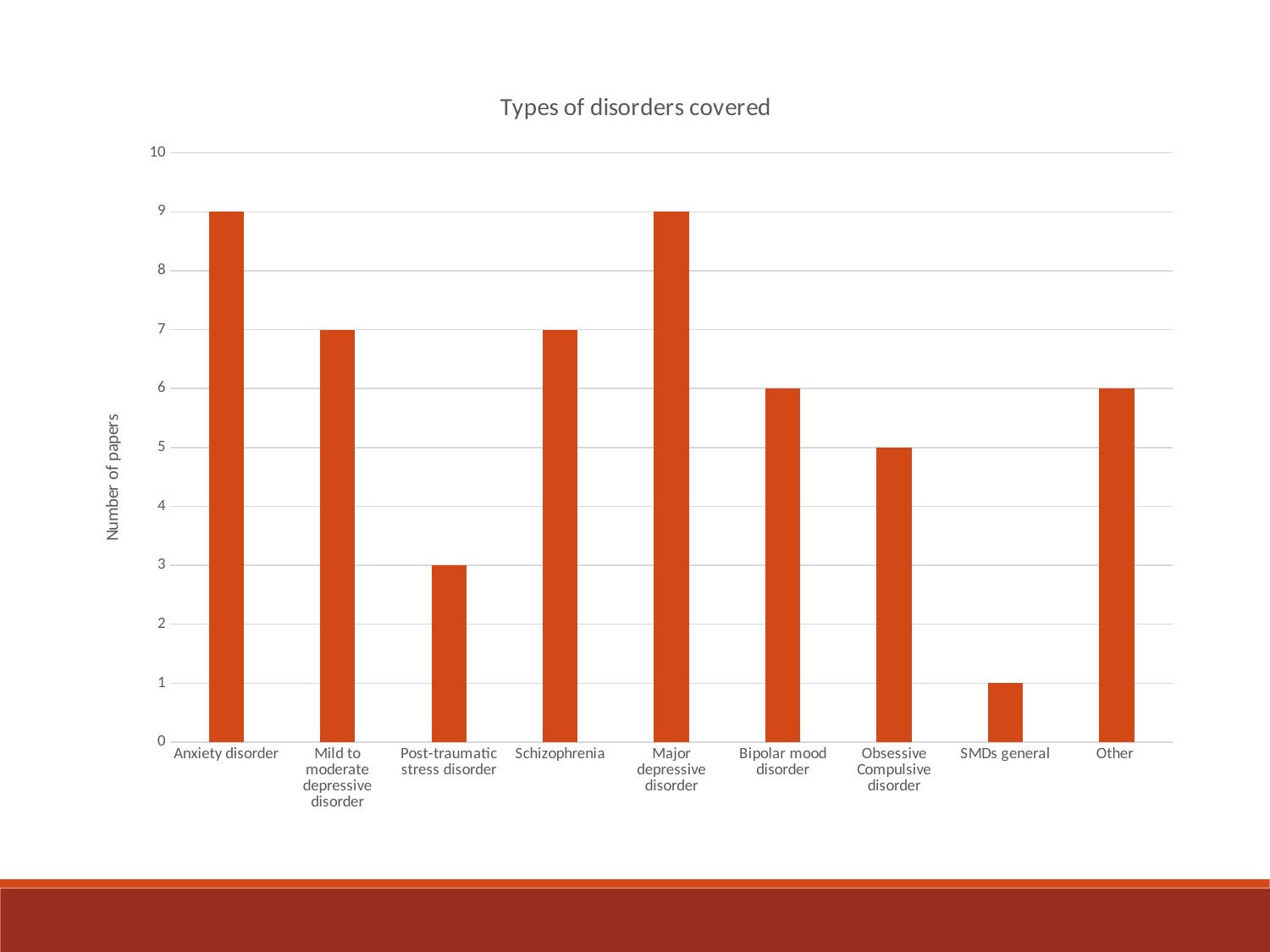
What is the number of papers for Obsessive Compulsive disorder? 5 What is the number of papers for Bipolar mood disorder? 6 What is the label of the y axis? Number of papers How many disorder categories are shown on the x axis? 9 Is the value for Major depressive disorder greater or less than 5? greater Which has more papers, Mild to moderate depressive disorder or Bipolar mood disorder? Mild to moderate depressive disorder What is the number of papers for Schizophrenia? 7 Which category has the lowest number of papers? SMDs general What kind of chart is shown on the slide? bar chart What is the number of papers for Post-traumatic stress disorder? 3 What is the difference in number of papers between Anxiety disorder and Post-traumatic stress disorder? 6 What is the title of the chart? Types of disorders covered